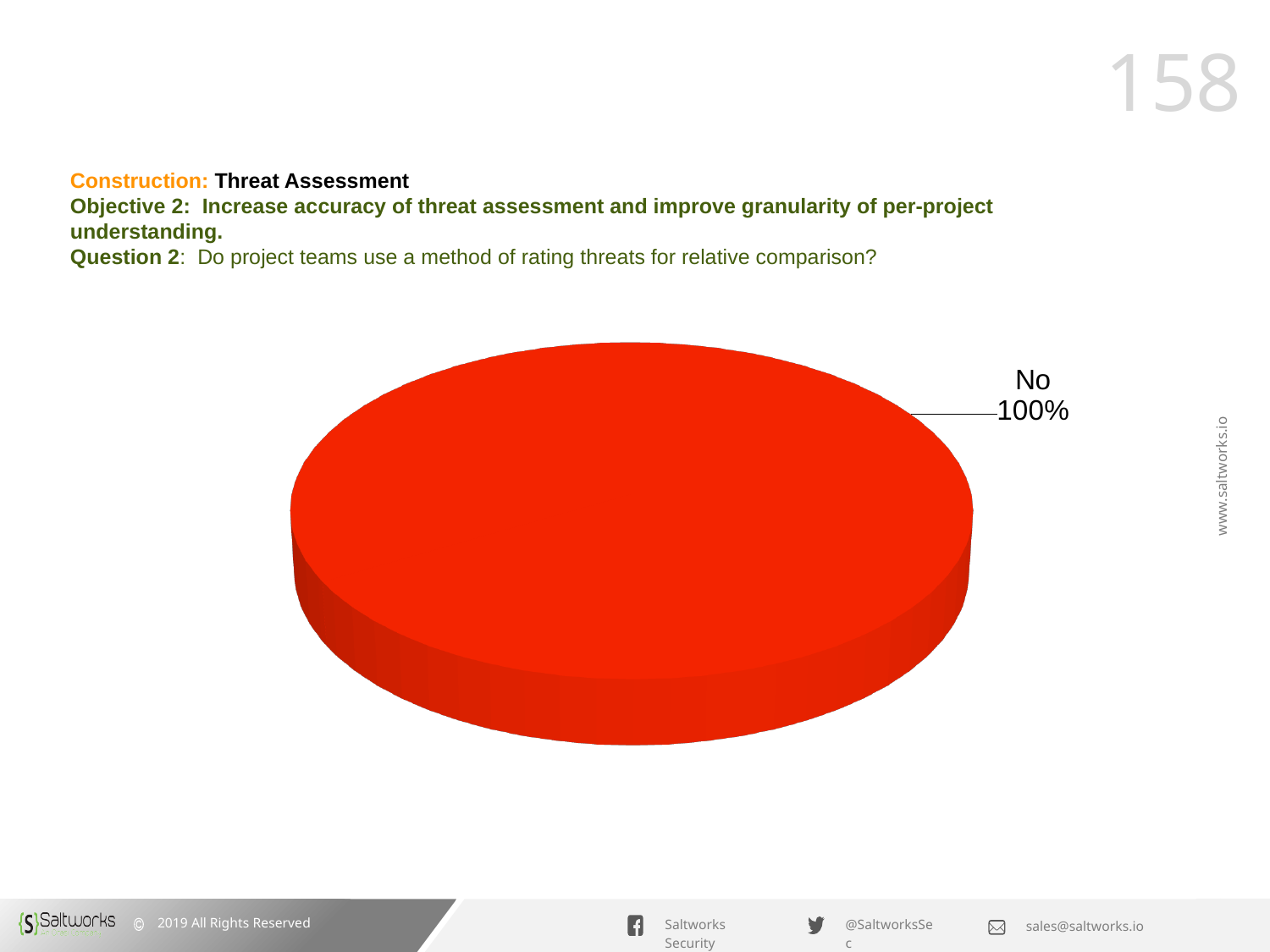
What colour is the "No" slice of the pie chart? red What is the value printed for the "No" category? 100% What share of the pie does the "No" slice represent? 100% How many slices are labelled on the pie chart? 1 Is the value for "No" greater or less than 50%? greater What kind of chart is shown on the slide? pie chart Which category is the largest slice of the pie chart? No What is the label of the only slice shown on the pie chart? No